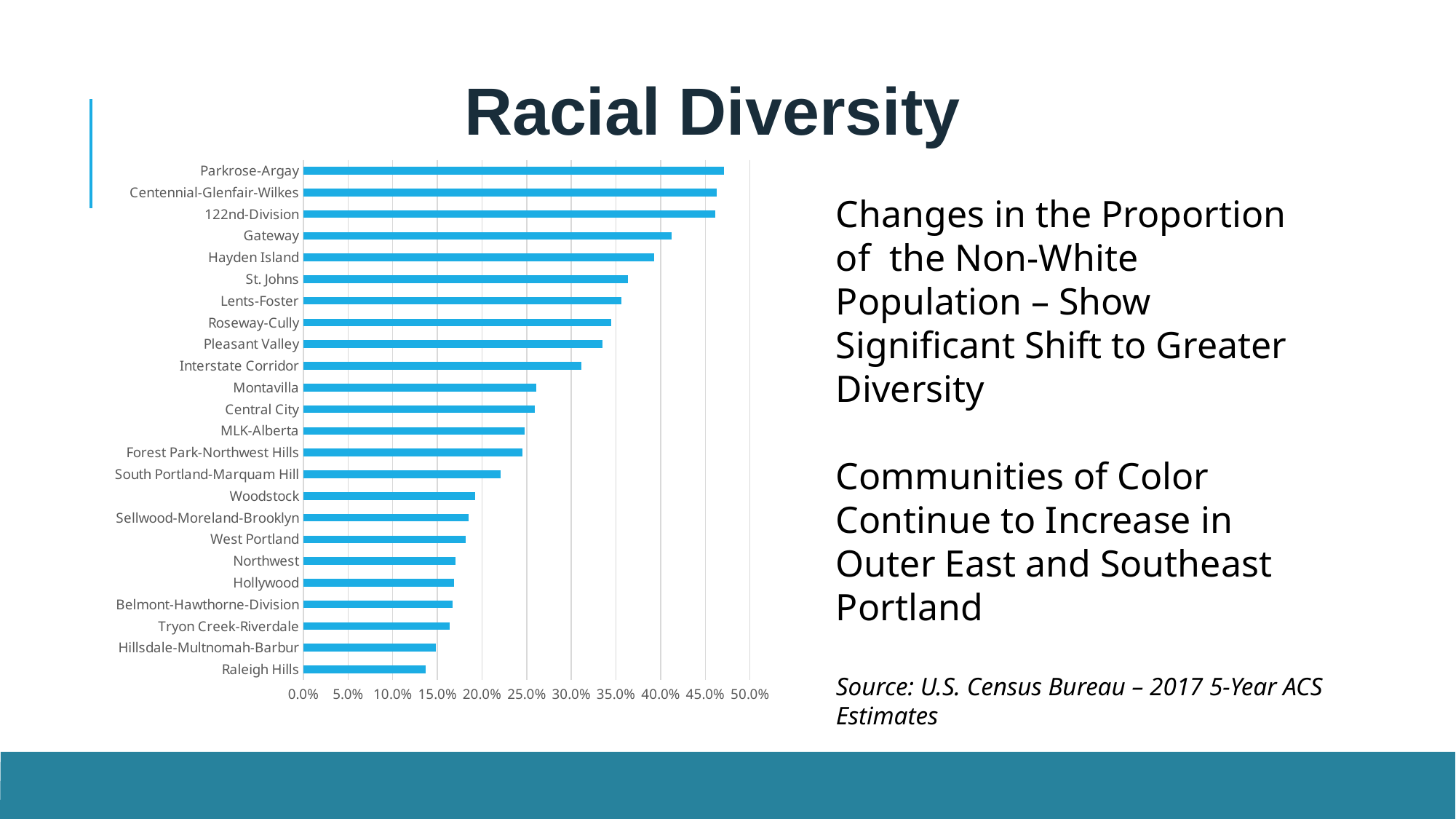
Which neighborhood has the lowest value on the chart? Raleigh Hills Which has a larger value, Gateway or Hayden Island? Gateway Which neighborhood has the highest value on the chart? Parkrose-Argay What kind of chart is shown on the slide? Bar chart Which has a larger value, Montavilla or Woodstock? Montavilla Is the value for Parkrose-Argay greater or less than 45.0%? greater What is the highest value shown on the horizontal axis of the chart? 50.0% How many neighborhoods are listed on the chart? 24 Is the value for Interstate Corridor greater or less than 30.0%? greater Is the value for Woodstock greater or less than 20.0%? less